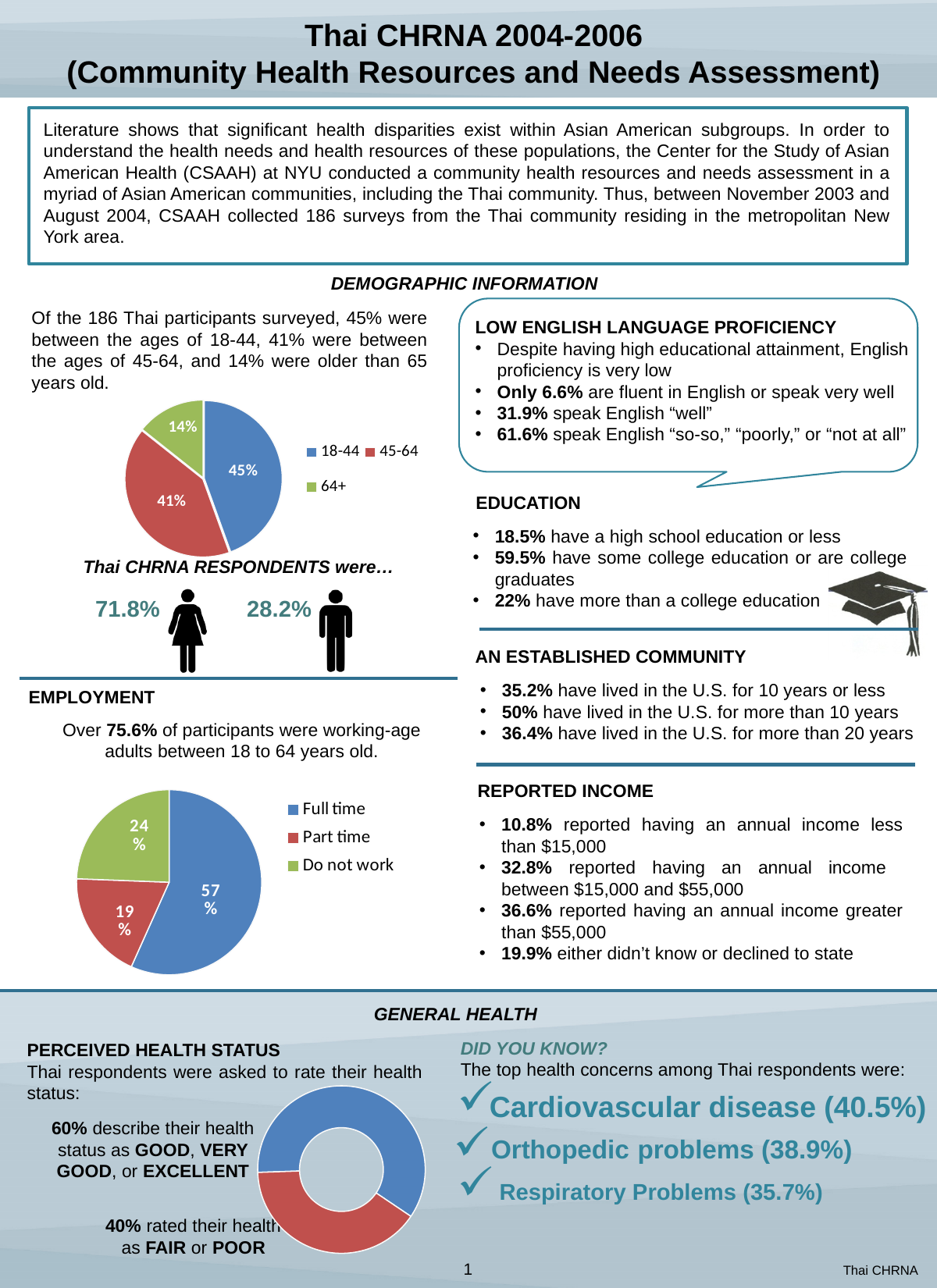
In the age pie chart under Demographic Information, what share of respondents were aged 18-44? 45% In the age pie chart under Demographic Information, how many percentage points larger is the 18-44 slice than the 45-64 slice? 4 In the Employment pie chart, how many percentage points larger is the Full time slice than the Do not work slice? 33 In the age pie chart under Demographic Information, which age group has the largest share? 18-44 What type of chart is used to show the Employment breakdown? Pie chart In the Employment pie chart, what share of participants do not work? 24% In the Employment pie chart, which category has the smallest share? Part time In the age pie chart under Demographic Information, how many age groups are shown? 3 In the Employment pie chart, which is larger: the Part time slice or the Do not work slice? Do not work In the age pie chart under Demographic Information, what share of respondents were aged 64+? 14% In the Employment pie chart, what share of participants work full time? 57% In the age pie chart under Demographic Information, which age group has the smallest share? 64+